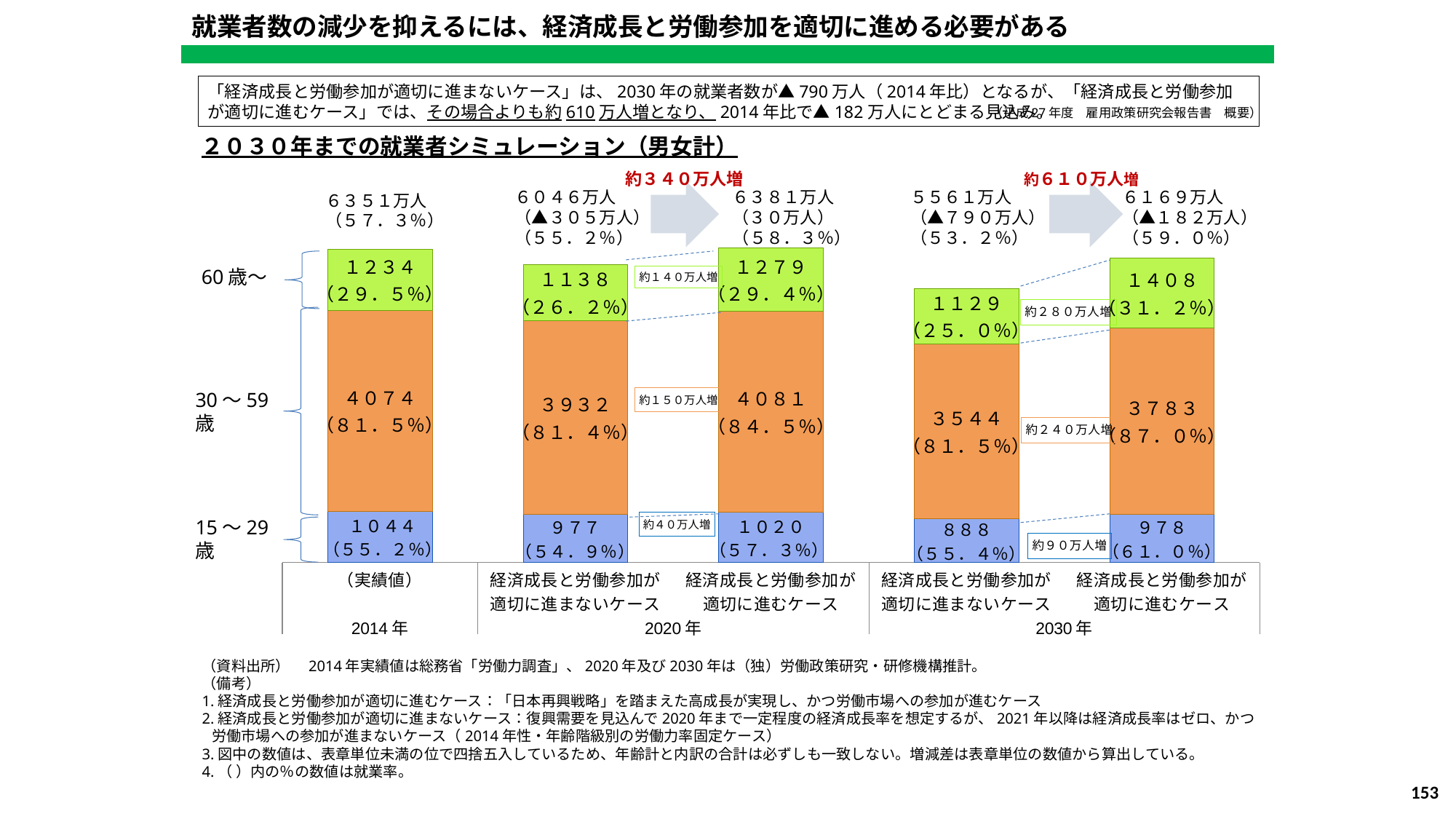
How many bars are plotted in the chart? 5 What is the total number of employed persons shown above the 2030年 経済成長と労働参加が適切に進まないケース bar? 5561万人 What is the value of the 30〜59歳 segment in the 2020年 経済成長と労働参加が適切に進むケース bar? 4081 Which is larger: the 60歳〜 segment in the 2014 bar or in the 2020年 経済成長と労働参加が適切に進むケース bar? 2020年 経済成長と労働参加が適切に進むケース (1279) Which bar has the lowest total number of employed persons? 2030年 経済成長と労働参加が適切に進まないケース, 5561万人 What employment rate (in parentheses) is shown for the total of the 2030年 経済成長と労働参加が適切に進むケース bar? 59.0% Which bar has the highest total number of employed persons? 2020年 経済成長と労働参加が適切に進むケース, 6381万人 How many age-group segments make up each stacked bar? 3 What kind of chart is shown on the slide? Stacked bar chart What is the difference between the 15〜29歳 value in 2014 (1044) and in the 2030年 経済成長と労働参加が適切に進まないケース bar (888)? 156 What increase is annotated in red above the arrow between the two 2030年 bars? 約６１０万人増 In the 2014年（実績値） bar, what is the value for the 60歳〜 segment? 1234